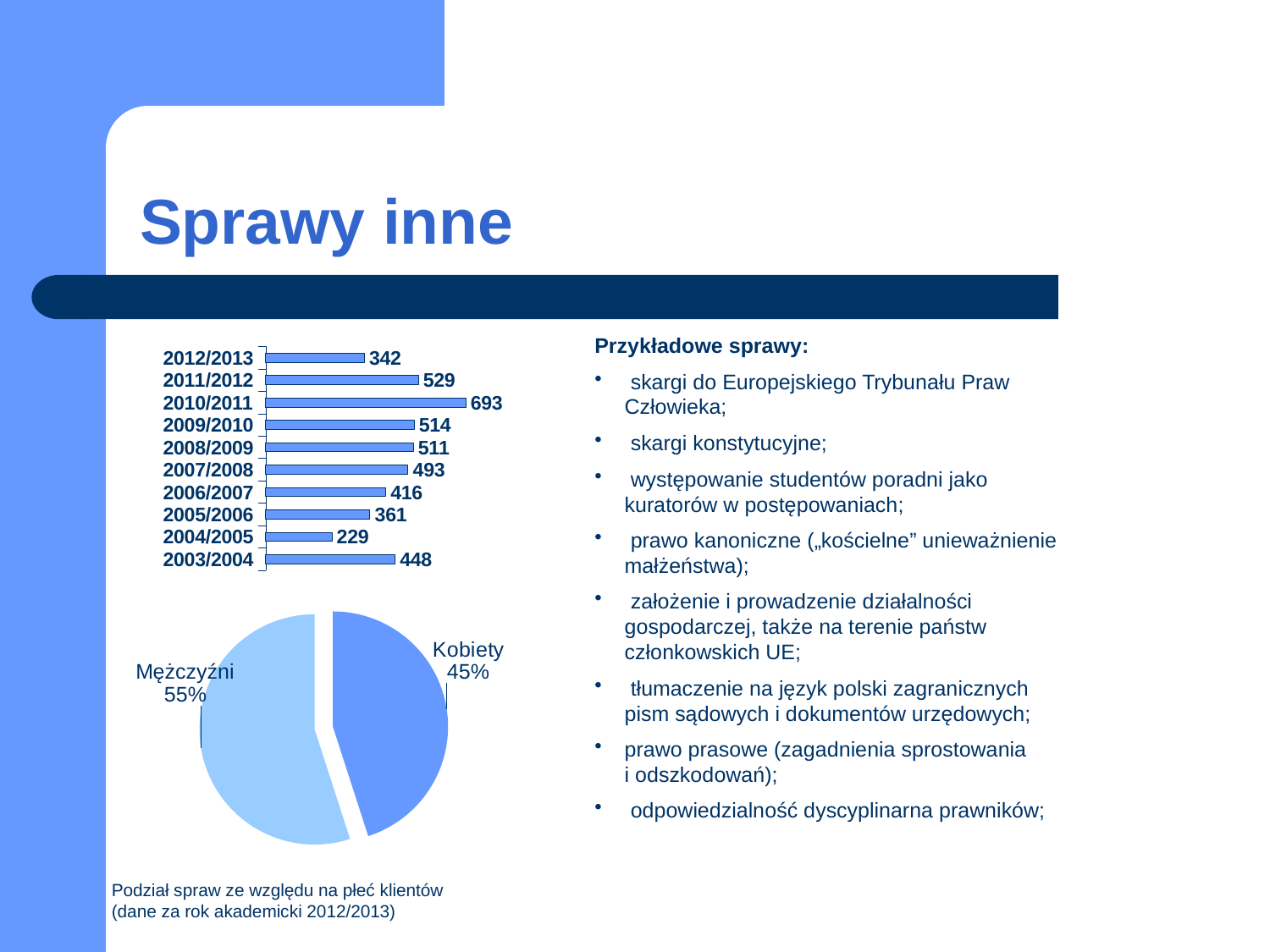
In the bar chart at the top left, which is larger, the value for 2003/2004 or the value for 2005/2006? 2003/2004 In the pie chart at the bottom left, what share is labelled Kobiety? 45% In the bar chart at the top left, which academic year has the highest value? 2010/2011 In the bar chart at the top left, what is the value for 2004/2005? 229 In the bar chart at the top left, what is the difference between the values for 2010/2011 and 2011/2012? 164 What kind of chart is the chart at the bottom left of the slide? Pie chart In the bar chart at the top left, which academic year has the lowest value? 2004/2005 In the bar chart at the top left, how many academic years are shown? 10 What kind of chart is the chart at the top left of the slide? Bar chart In the bar chart at the top left, what is the value for 2010/2011? 693 In the pie chart at the bottom left, which slice is larger, Mężczyźni or Kobiety? Mężczyźni In the bar chart at the top left, what is the value for 2012/2013? 342